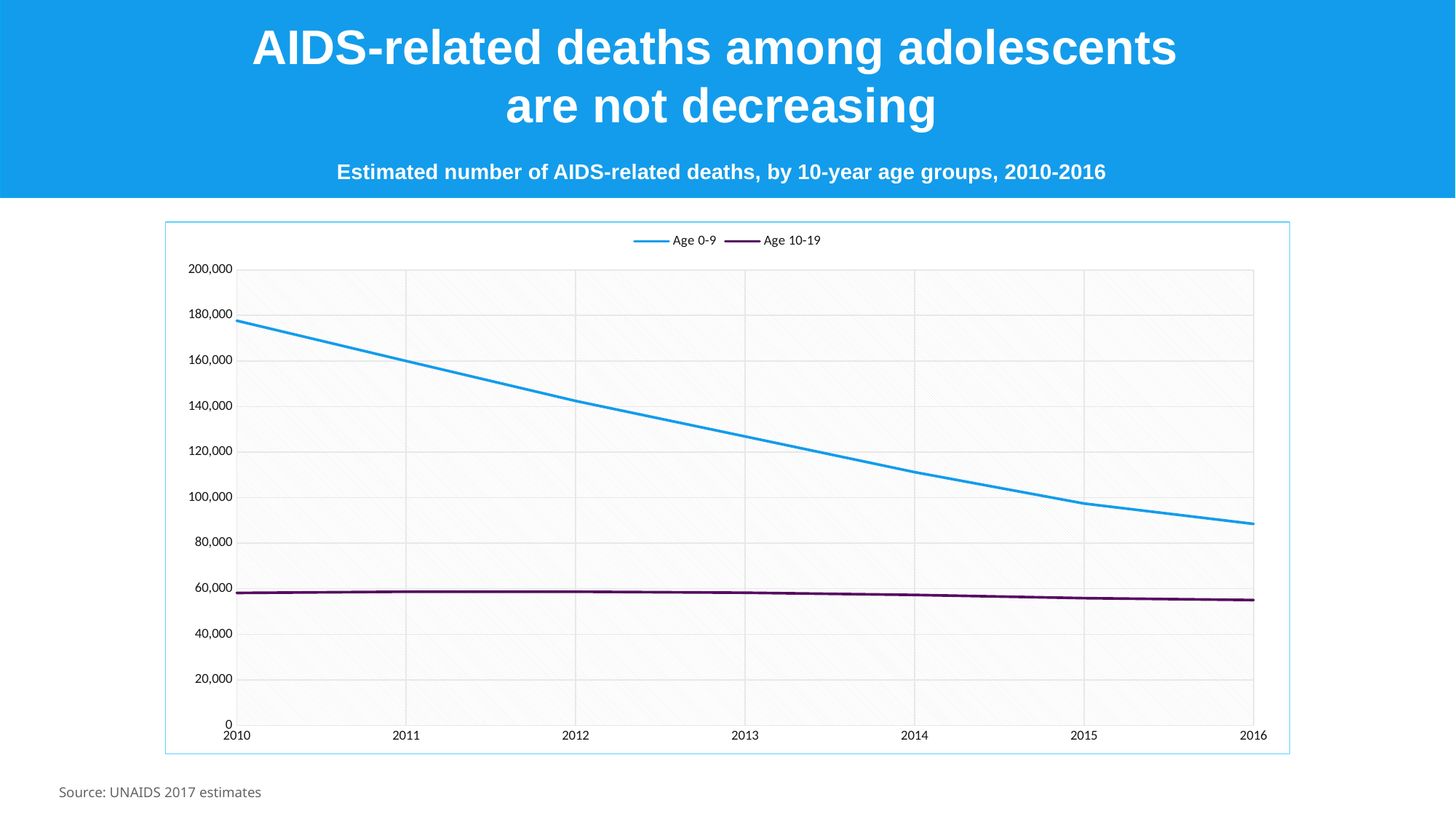
Is the value for Age 0-9 in 2010 greater or less than 160,000? greater How many series does the legend list? 2 Is the value for Age 0-9 in 2016 greater or less than 100,000? less In which year is the Age 0-9 value lowest? 2016 Which two series are listed in the legend? Age 0-9 and Age 10-19 Is the value for Age 10-19 in 2016 greater or less than 60,000? less What kind of chart is shown on the slide? line chart In which year is the Age 0-9 value highest? 2010 In 2016, which series has the larger value, Age 0-9 or Age 10-19? Age 0-9 How many years are shown along the x axis? 7 Does the Age 0-9 line rise or fall from 2010 to 2016? fall